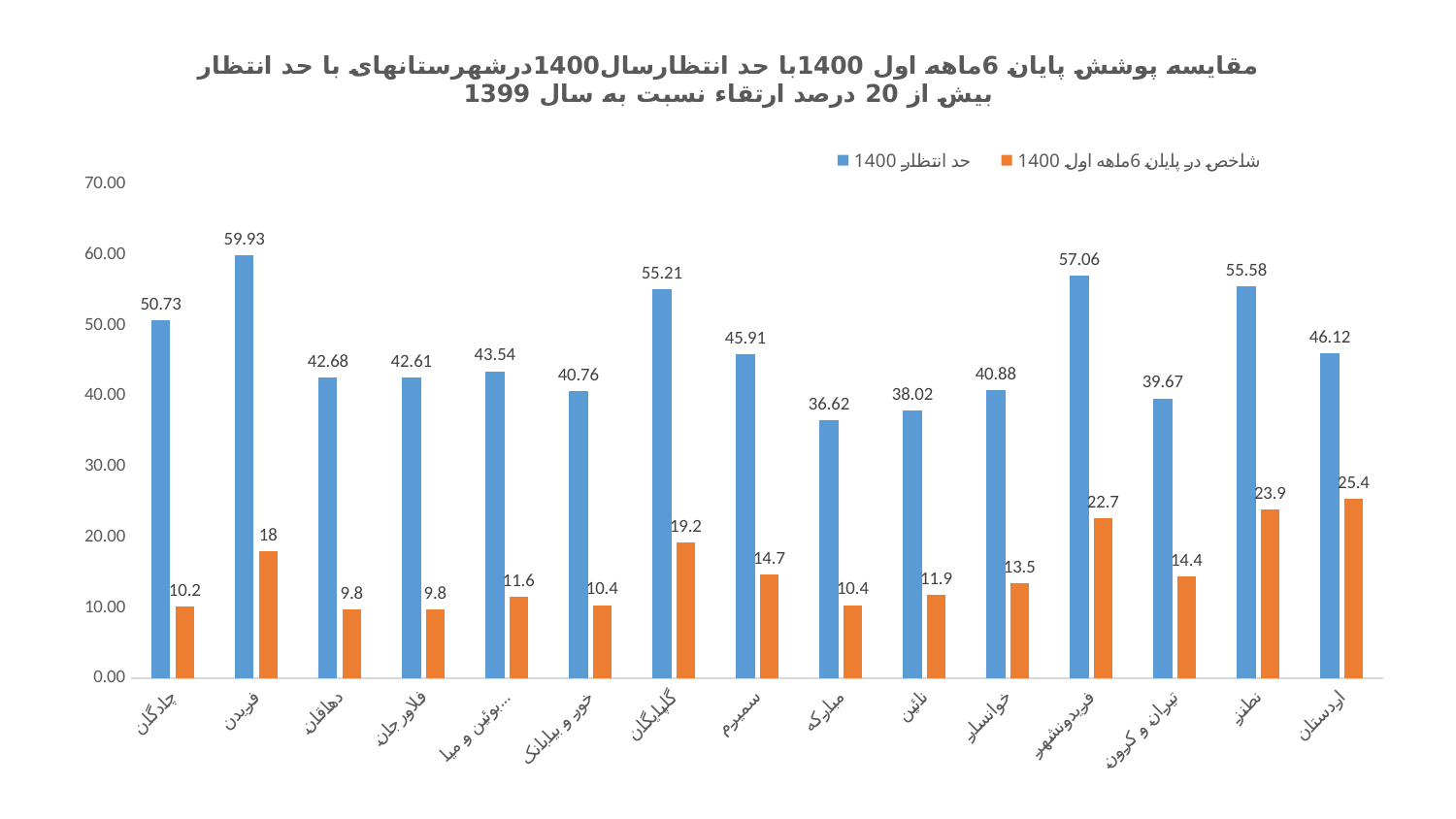
Which category has the lowest value for حد انتظار 1400? مبارکه Which category has the highest value for شاخص در پایان 6ماهه اول 1400? اردستان What is the difference between حد انتظار 1400 and شاخص در پایان 6ماهه اول 1400 for نطنز? 31.68 What is the value of شاخص در پایان 6ماهه اول 1400 for اردستان? 25.4 Is the value of شاخص در پایان 6ماهه اول 1400 for فریدونشهر greater or less than 20? greater What is the value of حد انتظار 1400 for مبارکه? 36.62 What type of chart is shown on the slide? bar chart How many categories are shown on the x axis? 15 How many series does the legend list? 2 Which category has the highest value for حد انتظار 1400? فریدن What is the value of حد انتظار 1400 for فریدن? 59.93 Which is larger: the حد انتظار 1400 value for گلپایگان or for فریدونشهر? فریدونشهر